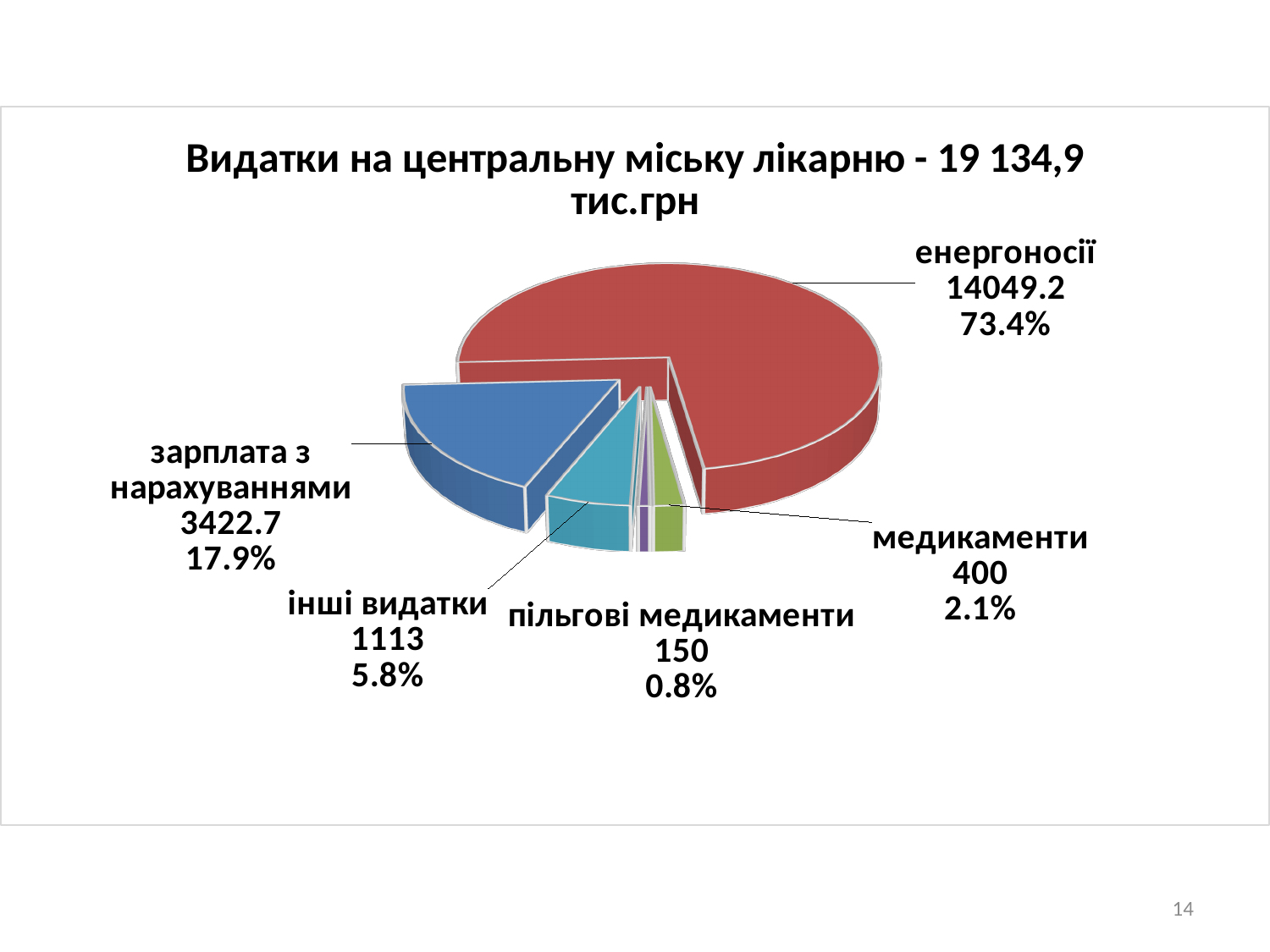
Which labelled category has the smallest slice of the pie? пільгові медикаменти Which category has the largest slice of the pie? енергоносії What is the title of the chart? Видатки на центральну міську лікарню - 19 134,9 тис.грн What percentage share does the зарплата з нарахуваннями slice have? 17.9% What percentage share does the медикаменти slice have? 2.1% What colour is the енергоносії slice? red What is the value shown for пільгові медикаменти? 150 Which is larger, the value for зарплата з нарахуваннями or the value for інші видатки? зарплата з нарахуваннями What is the value shown for енергоносії? 14049.2 What kind of chart is shown on the slide? pie chart What is the value shown for інші видатки? 1113 What is the difference between the values for медикаменти and пільгові медикаменти? 250